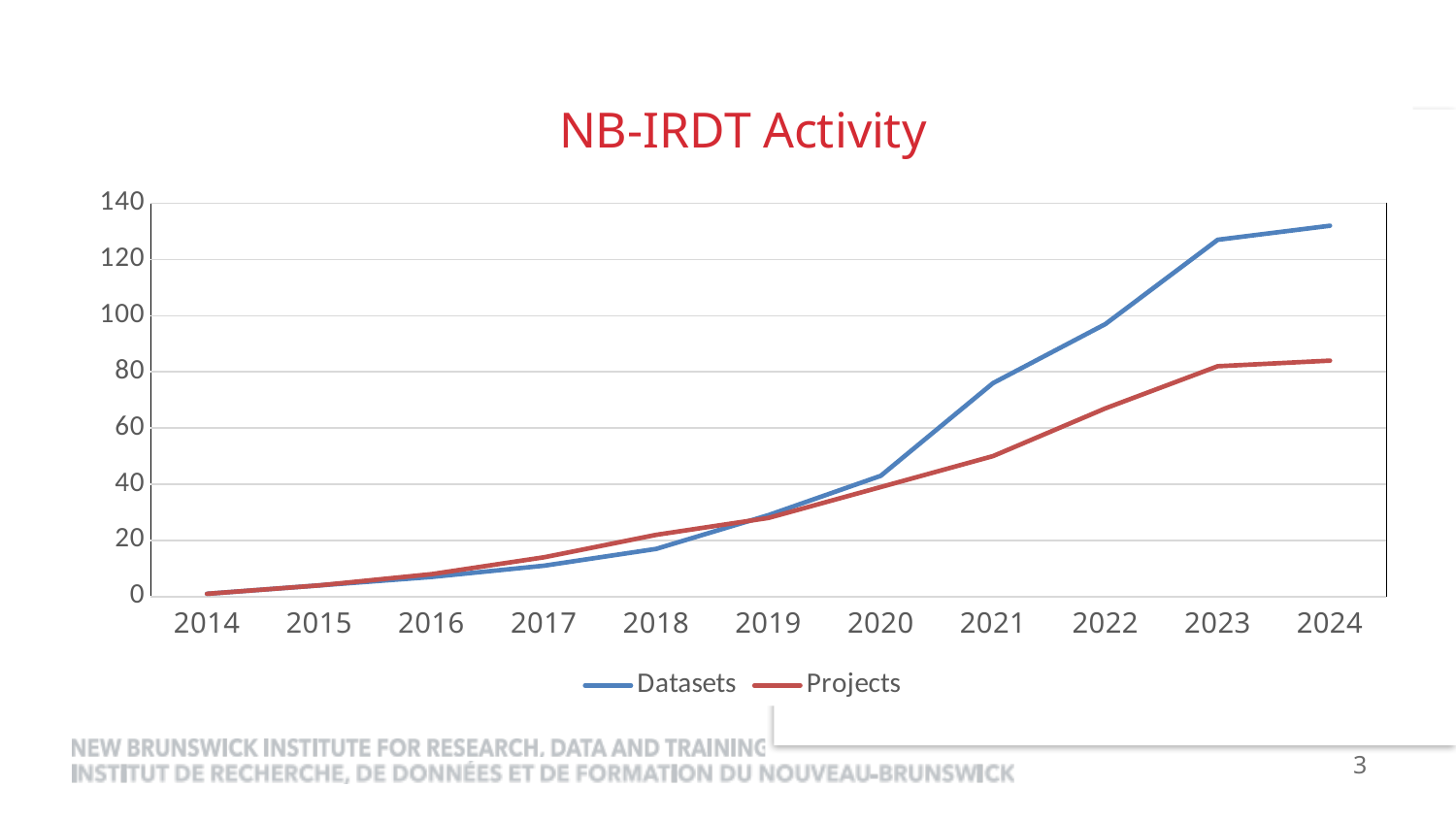
How many years are shown on the x axis? 11 Is the Projects value for 2023 greater or less than 60? greater In 2024, which series has the larger value, Datasets or Projects? Datasets What is the title of the chart? NB-IRDT Activity Is the Datasets value for 2024 greater or less than 120? greater Which colour is used for the Projects line? red Is the Datasets value for 2019 greater or less than 40? less Do the Datasets values rise or fall from 2014 to 2024? rise In which year is the Projects value lowest? 2014 How many series does the legend list? 2 In which year is the Datasets value highest? 2024 What kind of chart is shown on the slide? line chart